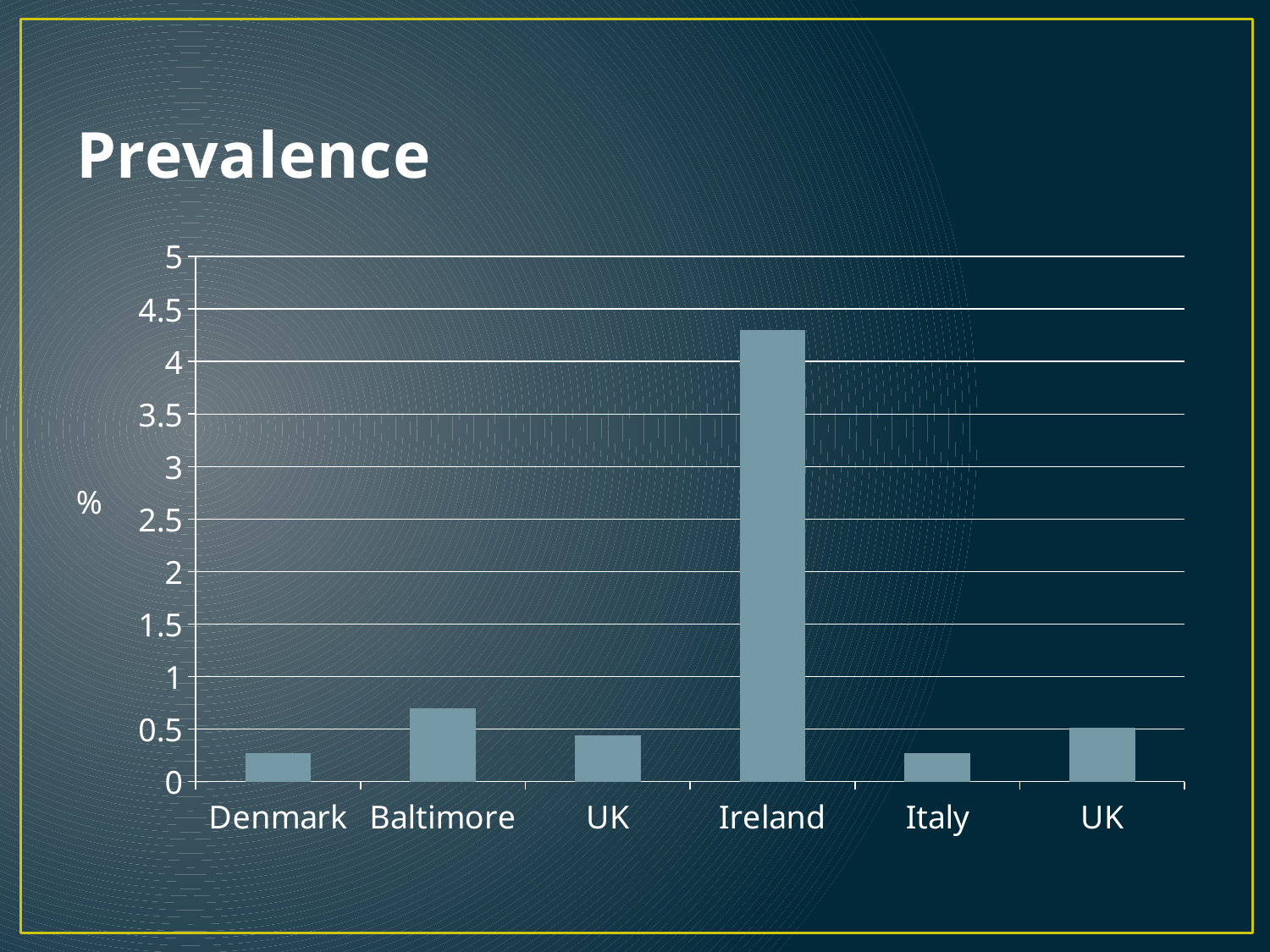
What type of chart is shown on the slide? bar chart What is the label on the vertical axis? % Is the value for Ireland greater or less than 4? greater What is the title of the chart? Prevalence Is the value for Ireland greater or less than 4.5? less How many bars are plotted in the chart? 6 Is the value for Denmark greater or less than 0.5? less Which category has the highest prevalence? Ireland Which is larger, the value for Ireland or the value for Baltimore? Ireland Which is larger, the value for Baltimore or the value for Denmark? Baltimore